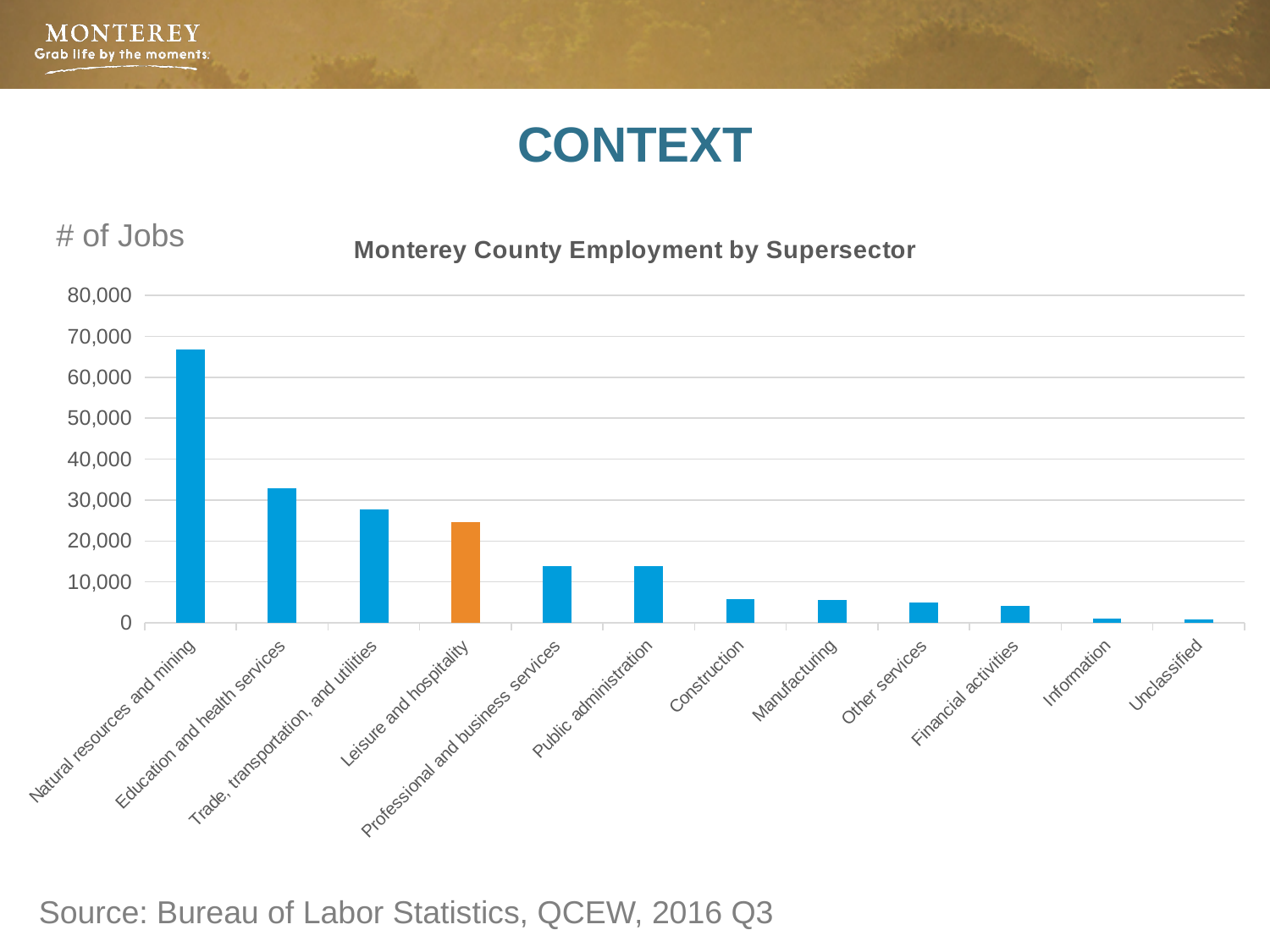
Do the values generally rise or fall moving from left to right along the x axis? fall Which supersector has the highest number of jobs? Natural resources and mining Is the value for Education and health services greater or less than 30,000? greater Which has more jobs, Public administration or Manufacturing? Public administration Which has more jobs, Education and health services or Trade, transportation, and utilities? Education and health services How many supersector categories are plotted on the chart? 12 Which supersector's bar is highlighted in orange? Leisure and hospitality Is the value for Construction greater or less than 10,000? less Is the value for Leisure and hospitality greater or less than 30,000? less What kind of chart is shown on the slide? bar chart What is the title of the chart? Monterey County Employment by Supersector